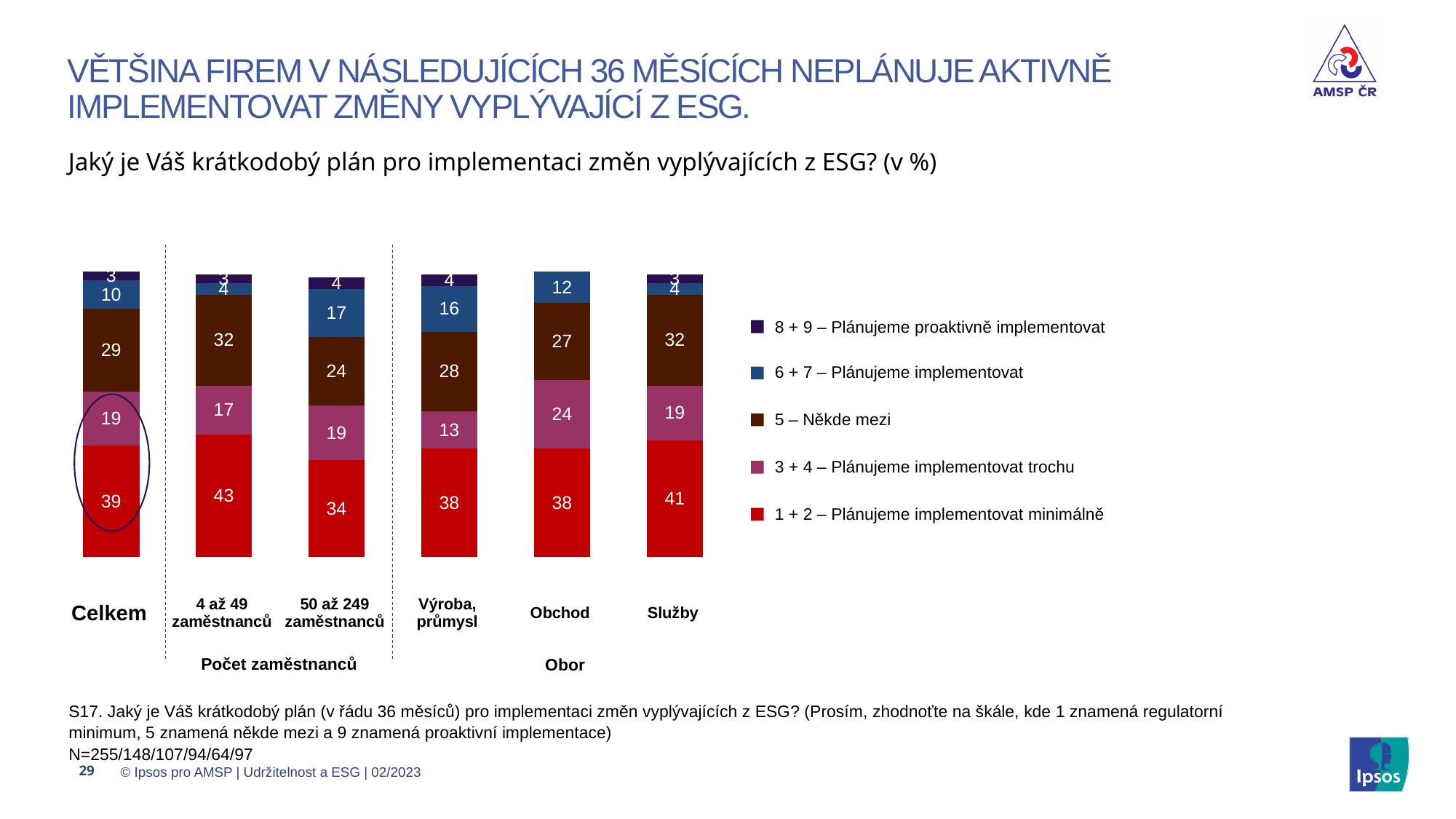
What is the difference between the '5 – Někde mezi' values for Služby and 50 až 249 zaměstnanců? 8 What is the value of '3 + 4 – Plánujeme implementovat trochu' for Obchod? 24 What is the value of '6 + 7 – Plánujeme implementovat' for 50 až 249 zaměstnanců? 17 How many series does the legend list? 5 Which legend entry is shown in red? 1 + 2 – Plánujeme implementovat minimálně Which is larger: the '6 + 7 – Plánujeme implementovat' value for Výroba, průmysl or for Obchod? Výroba, průmysl How many bars (categories) are plotted in the chart? 6 What is the total of the stacked bar for Celkem? 100 What kind of chart is shown on the slide? stacked bar chart What is the value of '1 + 2 – Plánujeme implementovat minimálně' for Celkem? 39 Which category has the lowest value for '1 + 2 – Plánujeme implementovat minimálně'? 50 až 249 zaměstnanců Which category has the highest value for '1 + 2 – Plánujeme implementovat minimálně'? 4 až 49 zaměstnanců